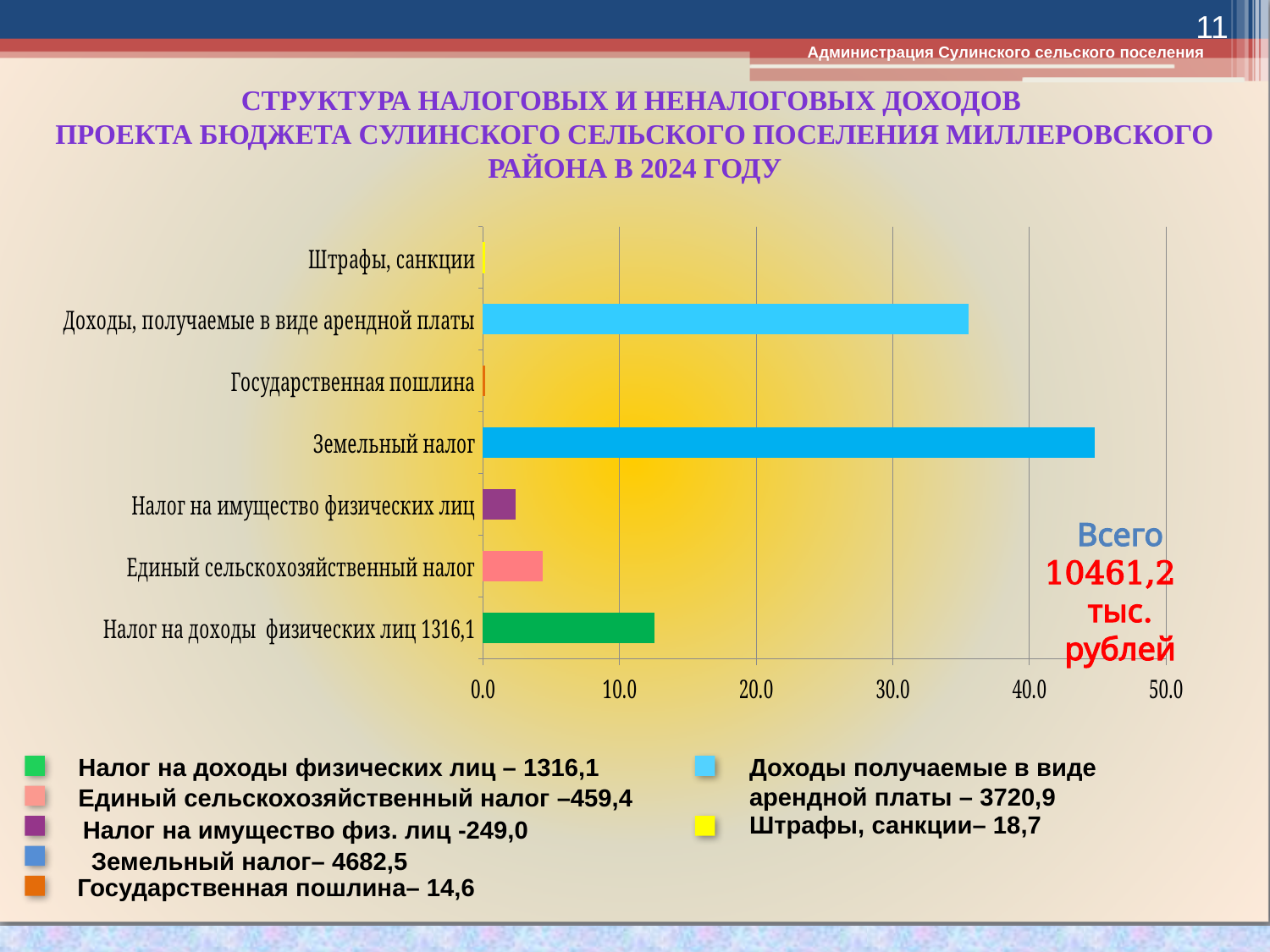
According to the legend amounts, which category has the smallest value? Государственная пошлина What amount is listed in the legend for Земельный налог? 4682,5 Is the value for Единый сельскохозяйственный налог greater or less than 10.0? less Which category has the longest bar in the chart? Земельный налог Is the value for Земельный налог greater or less than 40.0? greater What total (Всего) is shown on the chart, in тыс. рублей? 10461,2 What kind of chart is shown on the slide? bar chart Is the value for Доходы, получаемые в виде арендной платы greater or less than 30.0? greater What amount is listed in the legend for Штрафы, санкции? 18,7 How many categories are plotted in the chart? 7 Which of the two bars is longer: Земельный налог or Доходы, получаемые в виде арендной платы? Земельный налог